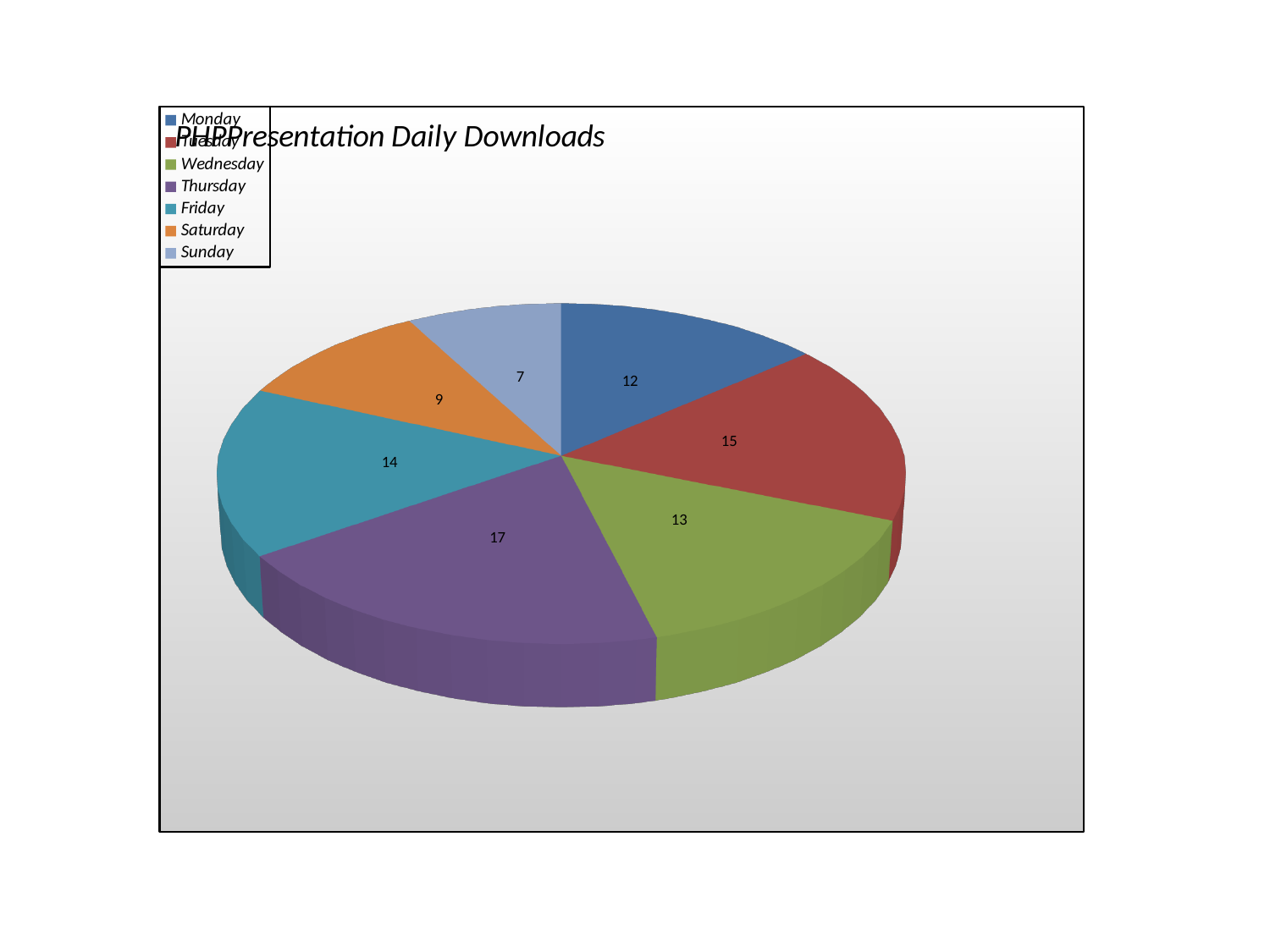
What is the difference between the values for Tuesday and Monday? 3 Which is larger, the value for Friday or the value for Wednesday? Friday Which day has the largest slice of the pie? Thursday How many slices does the pie chart have? 7 What is the value for Tuesday? 15 What is the value for Saturday? 9 What is the value for Thursday? 17 What is the value for Sunday? 7 What is the difference between the values for Thursday and Sunday? 10 What type of chart is shown on the slide? Pie chart What is the title of the chart? PHPPresentation Daily Downloads Which day has the smallest slice of the pie? Sunday